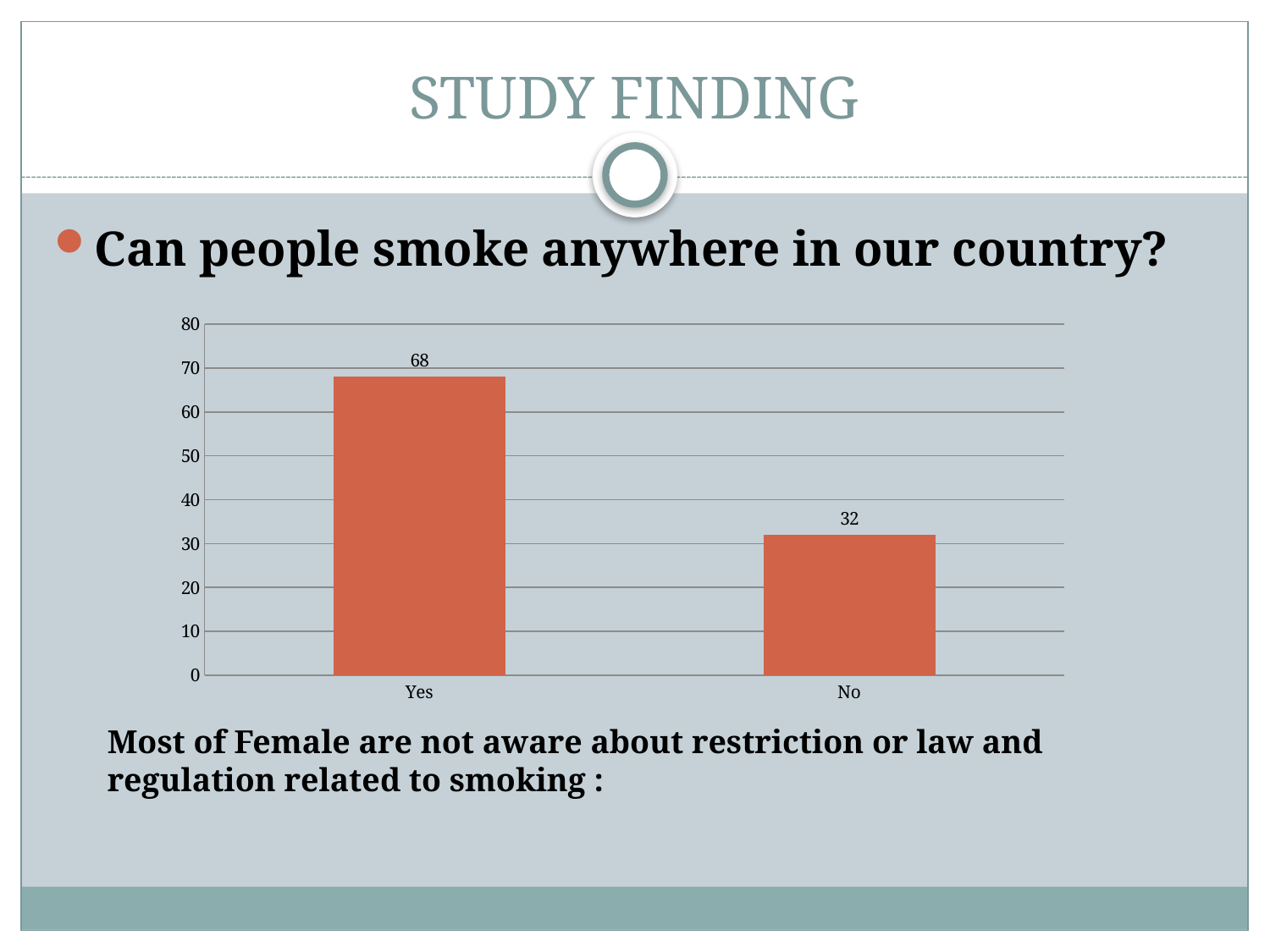
What is the value for Yes? 68 What is the highest value shown on the y axis? 80 How many categories are shown on the x axis? 2 What colour are the bars in the chart? orange-red Which is larger, the value for Yes or the value for No? Yes What kind of chart is shown on the slide? bar chart What is the difference between the values for Yes and No? 36 Which category has the highest value? Yes Is the value for No greater or less than 40? less Which category has the lowest value? No Is the value for Yes greater or less than 60? greater What is the value for No? 32